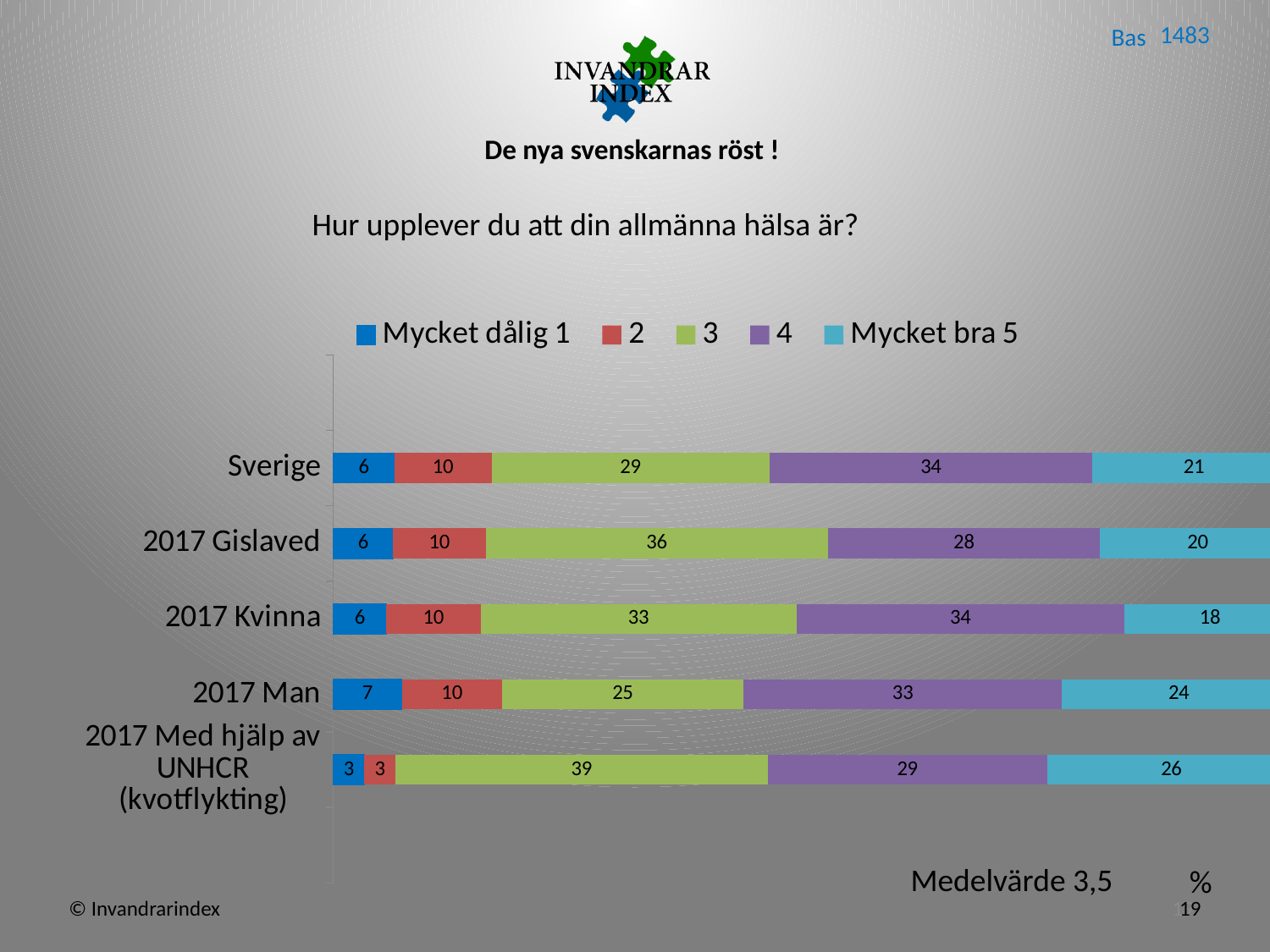
What is the value of "Mycket dålig 1" for 2017 Med hjälp av UNHCR (kvotflykting)? 3 What is the title of the chart? Hur upplever du att din allmänna hälsa är? Which is larger: the series "4" value for Sverige or for 2017 Gislaved? Sverige What is the difference between the "Mycket bra 5" values for 2017 Man and 2017 Kvinna? 6 Which category has the highest value for series "3"? 2017 Med hjälp av UNHCR (kvotflykting) What is the value of "Mycket bra 5" for 2017 Man? 24 How many categories are plotted on the chart? 5 What kind of chart is shown on the slide? stacked bar chart How many series does the legend list? 5 Which category has the lowest value for "Mycket bra 5"? 2017 Kvinna What is the total of the stacked bar for 2017 Man? 99 What is the value of series "3" for 2017 Gislaved? 36